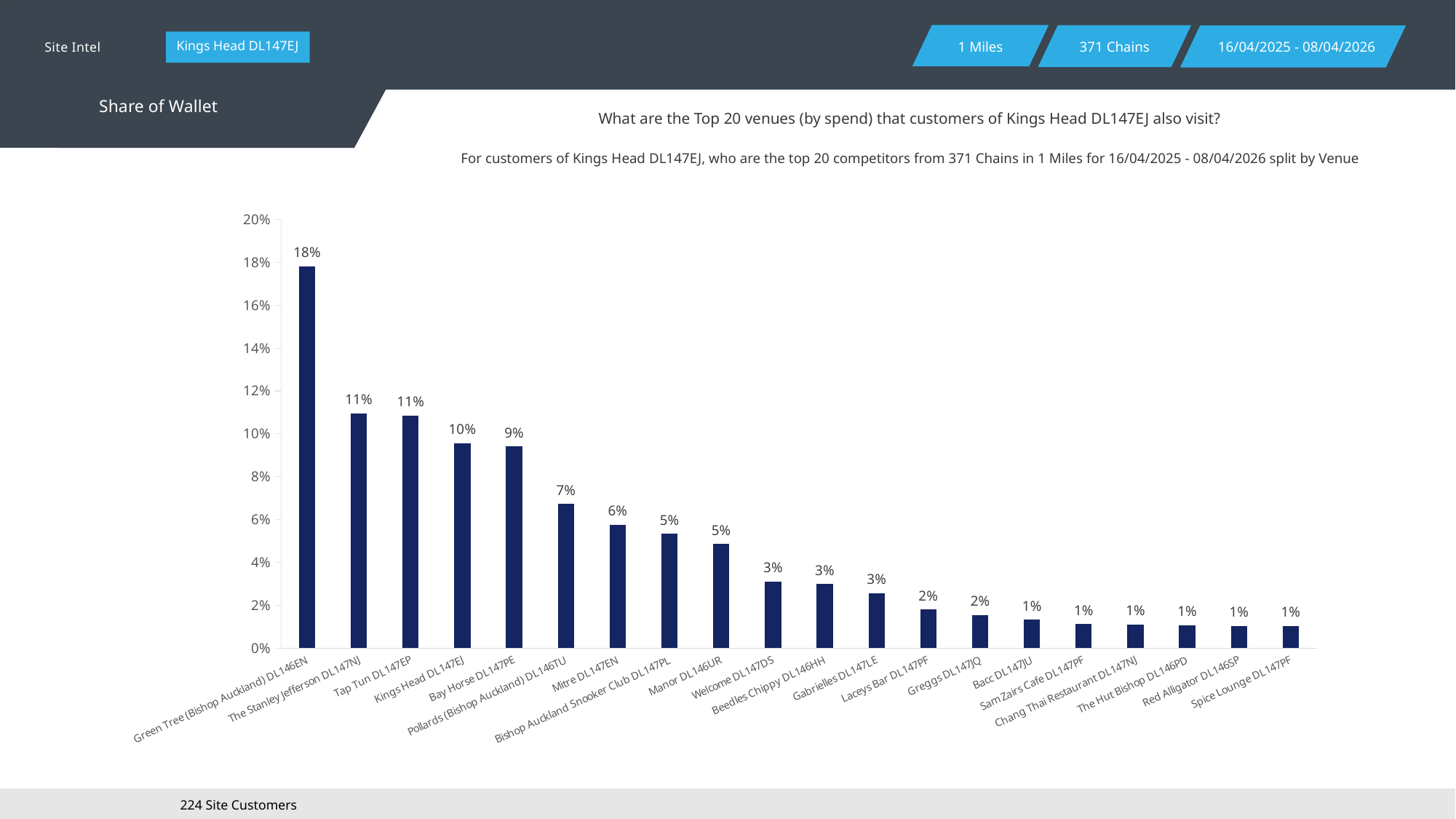
Do the values rise or fall from left to right along the x axis? fall How many venues are shown on the chart? 20 What is the value for Green Tree (Bishop Auckland) DL146EN? 18% What kind of chart is shown on the slide? bar chart What is the value for Welcome DL147DS? 3% What is the value for Kings Head DL147EJ? 10% Is the value for Green Tree (Bishop Auckland) DL146EN greater or less than 16%? greater What is the value for Mitre DL147EN? 6% Which is larger, the value for Bay Horse DL147PE or the value for Mitre DL147EN? Bay Horse DL147PE Which venue has the highest value? Green Tree (Bishop Auckland) DL146EN What is the value for Pollards (Bishop Auckland) DL146TU? 7% What is the difference between the values for Green Tree (Bishop Auckland) DL146EN and Kings Head DL147EJ? 8%